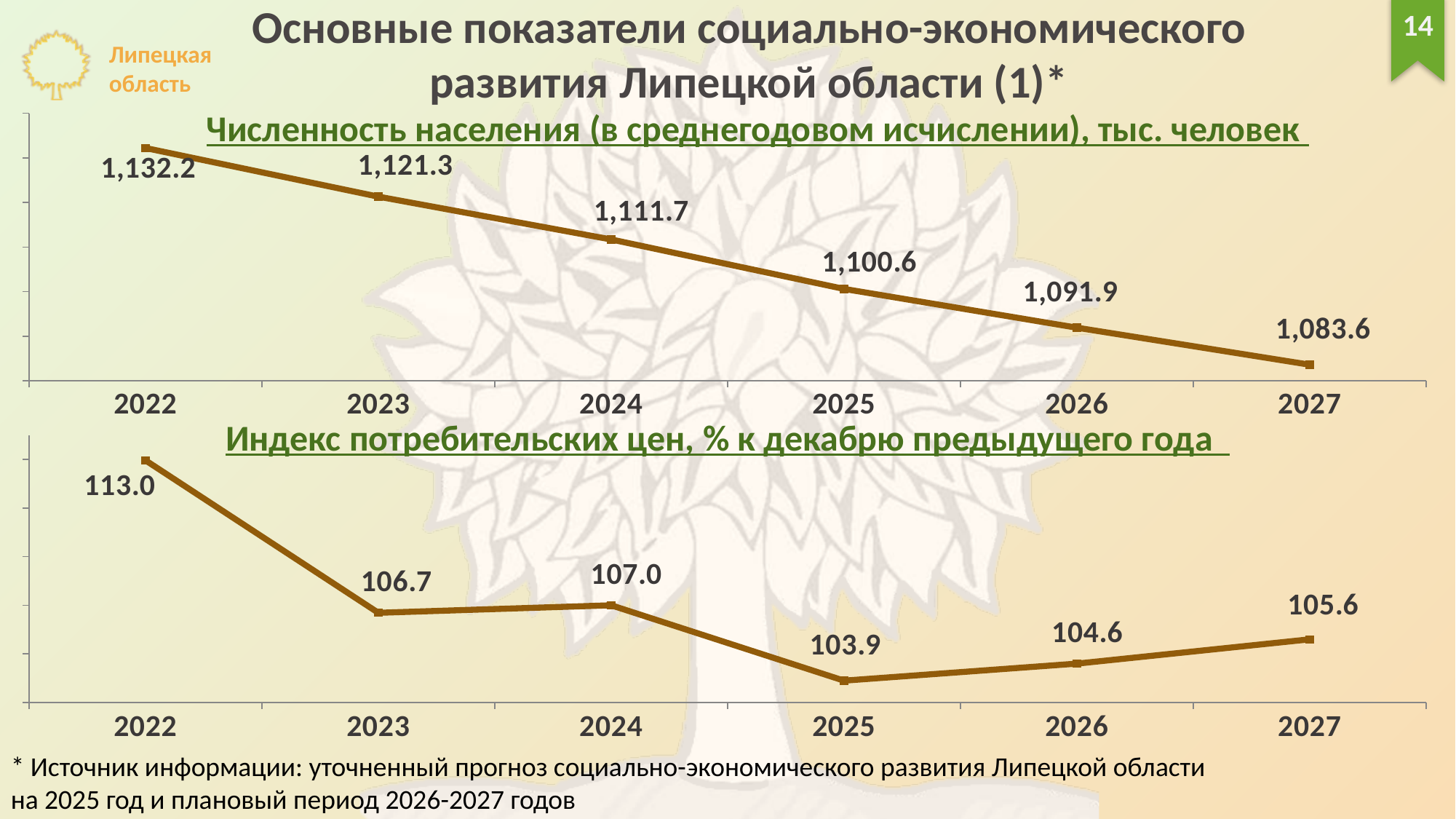
In the bottom chart (Индекс потребительских цен), which year has the highest value? 2022 In the bottom chart (Индекс потребительских цен), which year has the lowest value? 2025 In the top chart (Численность населения), what is the difference between the 2022 and 2023 values? 10.9 In the bottom chart (Индекс потребительских цен), what is the value for 2025? 103.9 In the top chart (Численность населения), what is the value for 2024? 1,111.7 In the top chart (Численность населения), do the values rise or fall from 2022 to 2027? fall What type of chart is the bottom chart (Индекс потребительских цен)? line chart In the bottom chart (Индекс потребительских цен), what is the difference between the 2022 and 2027 values? 7.4 In the bottom chart (Индекс потребительских цен), which is larger: the value for 2023 or the value for 2024? 2024 In the top chart (Численность населения), how many years are plotted? 6 In the top chart (Численность населения), what is the value for 2027? 1,083.6 In the top chart (Численность населения), which year has the highest value? 2022